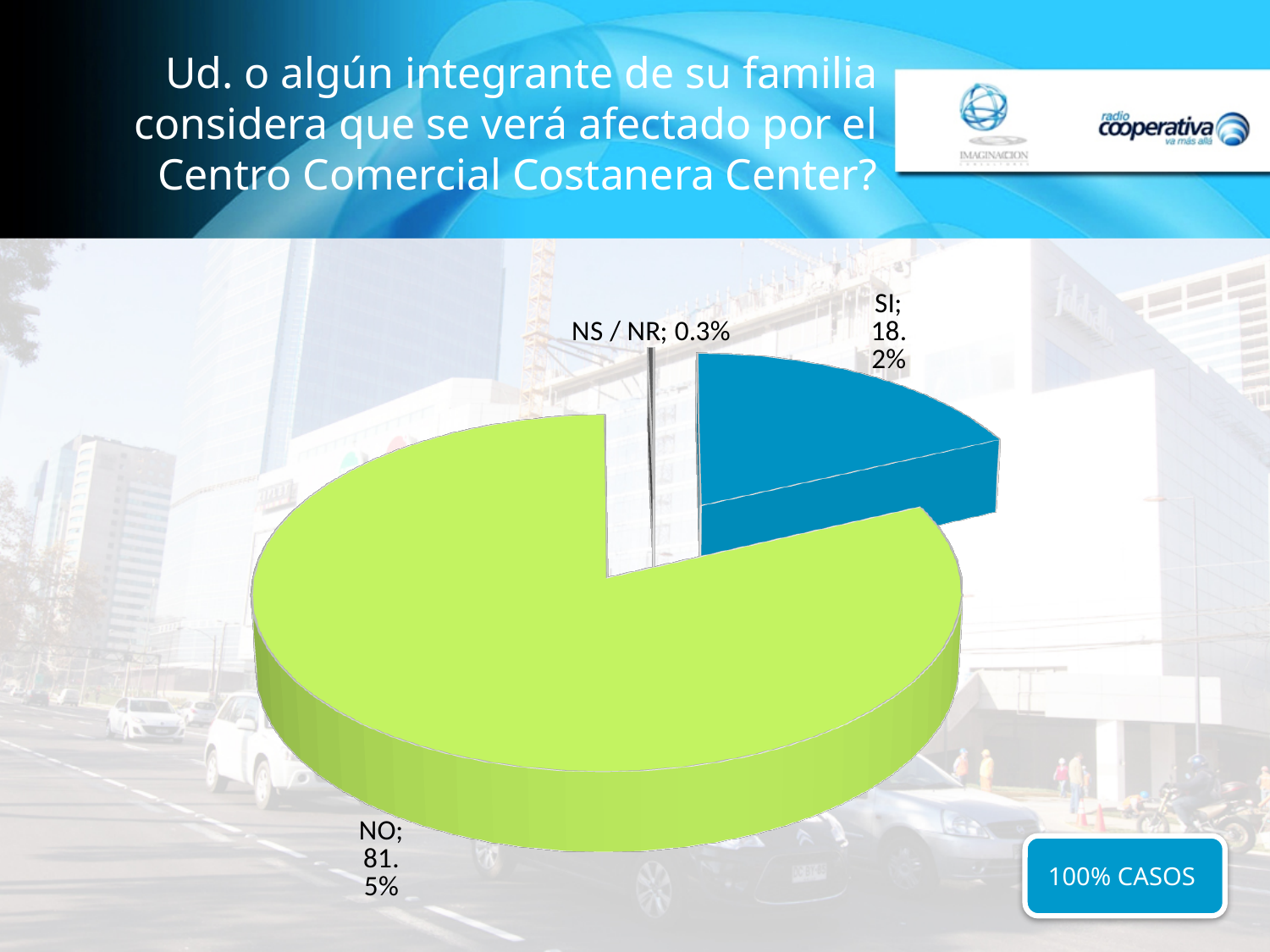
What is the difference in percentage points between NO and SI? 63.3 What kind of chart is shown on the slide? pie chart Which category has the smallest slice of the pie? NS / NR Which is larger, the share for SI or the share for NS / NR? SI Which category has the largest slice of the pie? NO What percentage is shown for NS / NR? 0.3% What text appears in the box at the bottom right of the slide? 100% CASOS What share of the pie does the NO slice represent? 81.5% How many slices does the pie chart have? 3 What percentage of respondents answered SI? 18.2% What colour is the SI slice of the pie? blue What percentage of respondents answered NO? 81.5%